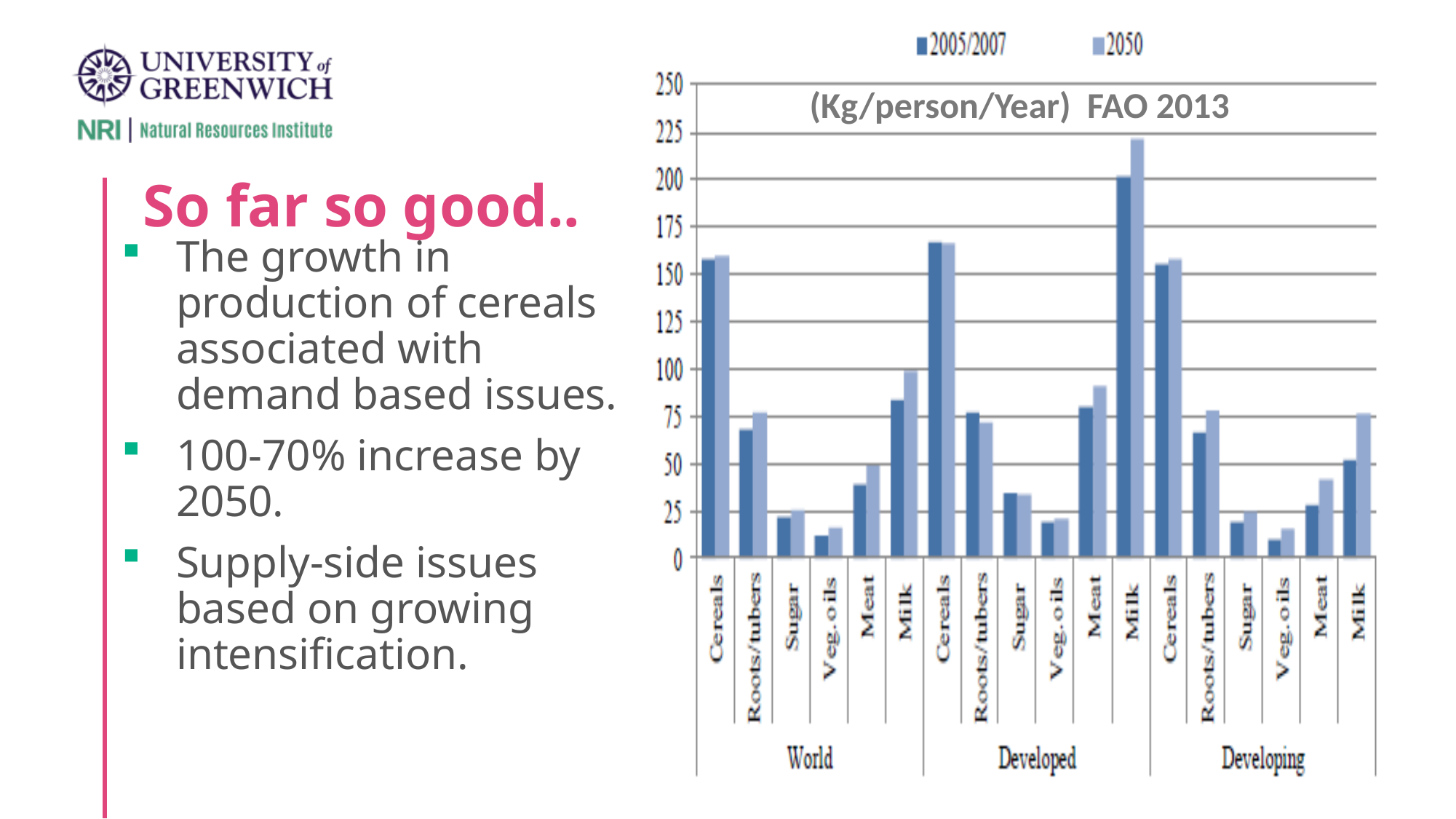
Is the 2050 value for Milk in the Developed group greater or less than 200? greater For Meat in the Developing group, which is larger: the 2005/2007 value or the 2050 value? 2050 Is the 2005/2007 value for Cereals in the World group greater or less than 150? greater What unit is stated for the values in the chart? Kg/person/Year Is the 2050 value for Meat in the Developed group greater or less than 100? less What kind of chart is shown on the slide? Bar chart How many region groups are shown along the x axis? 3 How many food categories are shown within each region group? 6 What are the two series named in the legend? 2005/2007 and 2050 How many series does the legend list? 2 Which bar is the highest in the whole chart? Milk, Developed, 2050 Which bar is the lowest in the whole chart? Veg. oils, Developing, 2005/2007